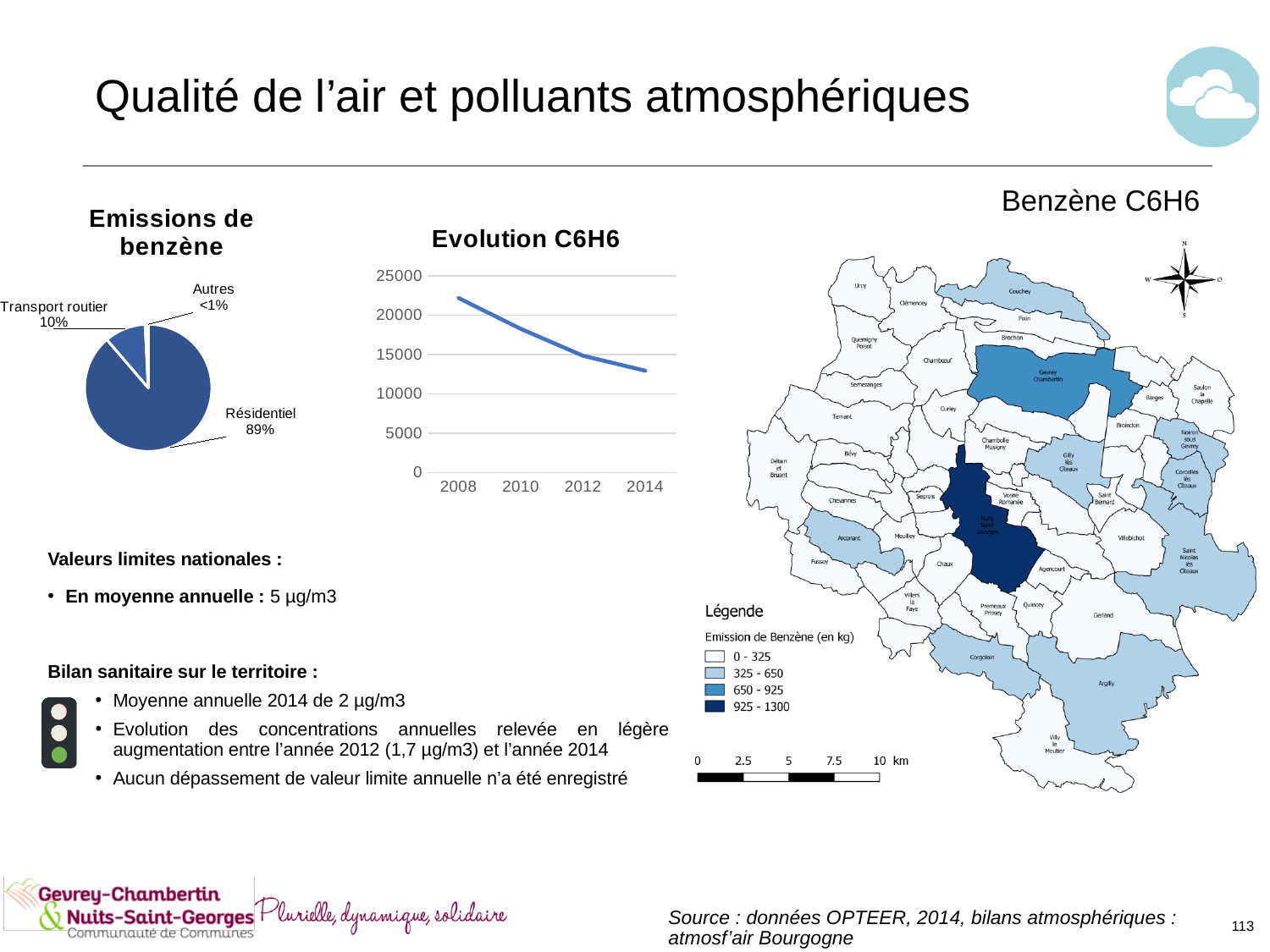
How many categories are shown in the 'Emissions de benzène' chart? 3 In the 'Emissions de benzène' chart, what share of emissions comes from Résidentiel? 89% In the 'Emissions de benzène' chart, which category has the largest share? Résidentiel In the 'Emissions de benzène' chart, what is the difference in percentage points between Résidentiel and Transport routier? 79 What kind of chart is 'Evolution C6H6'? Line chart In the 'Evolution C6H6' chart, is the value for 2014 greater or less than 15000? less In the 'Evolution C6H6' chart, is the value for 2008 greater or less than 20000? greater In the 'Emissions de benzène' chart, what share of emissions comes from Transport routier? 10% What kind of chart is 'Emissions de benzène'? Pie chart In the 'Emissions de benzène' chart, which category has the smallest share? Autres In the 'Emissions de benzène' chart, what share is shown for Autres? <1% In the 'Evolution C6H6' chart, do the values rise or fall from 2008 to 2014? Fall